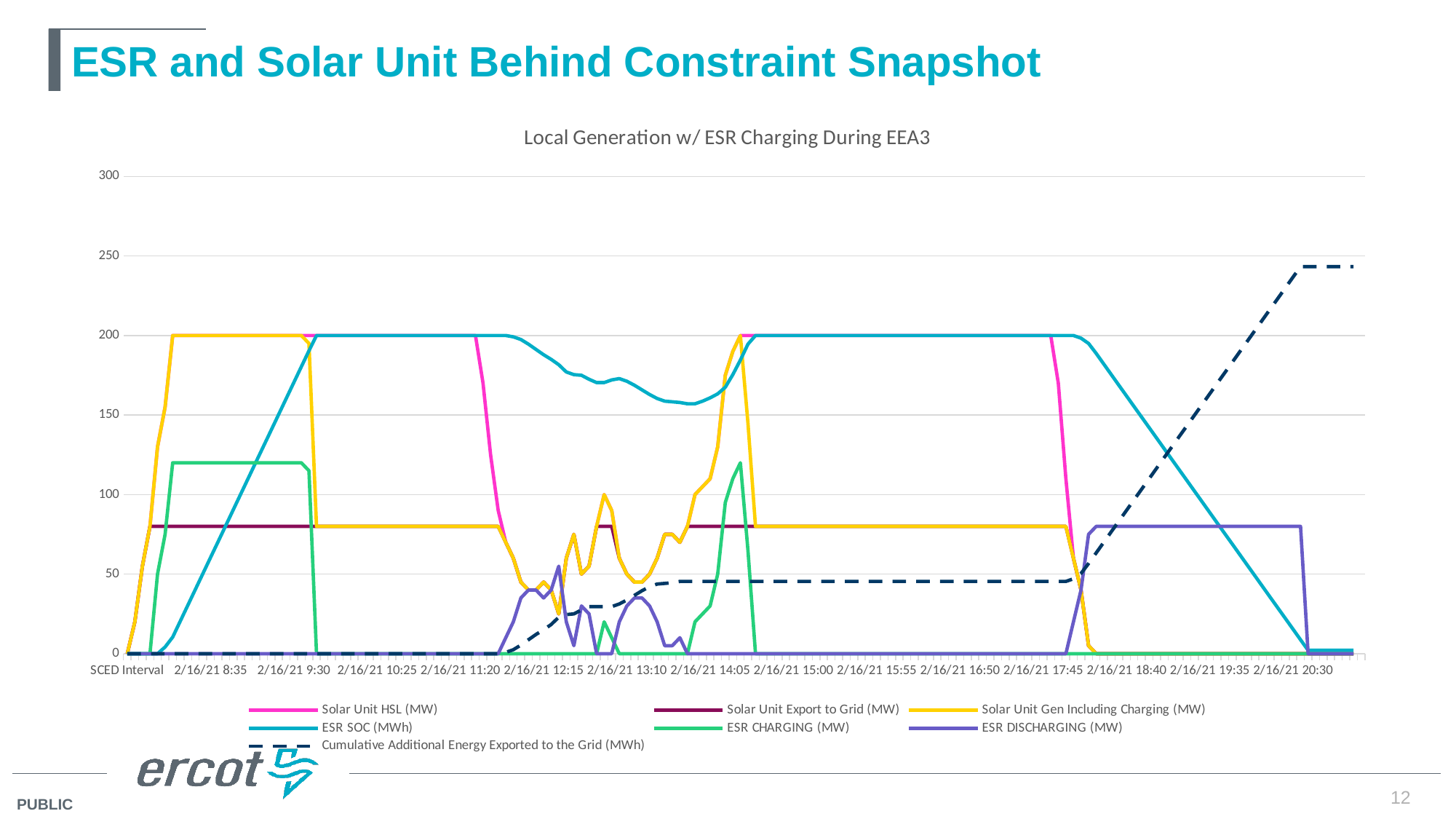
What kind of chart is shown on the slide? Line chart What is the title of the chart? Local Generation w/ ESR Charging During EEA3 Is the value of Cumulative Additional Energy Exported to the Grid (MWh) at 2/16/21 20:30 greater or less than 200? greater How many series does the legend list? 7 Is the value of ESR DISCHARGING (MW) at 2/16/21 19:35 greater or less than 50? greater Which series is drawn as a dashed line? Cumulative Additional Energy Exported to the Grid (MWh) Is the value of ESR SOC (MWh) at 2/16/21 15:00 greater or less than 150? greater Does the Cumulative Additional Energy Exported to the Grid (MWh) series rise or fall between 2/16/21 17:45 and 2/16/21 19:35? Rise What is the highest value reached by the Solar Unit HSL (MW) series? 200 Does the ESR SOC (MWh) series rise or fall between 2/16/21 18:40 and 2/16/21 20:30? Fall